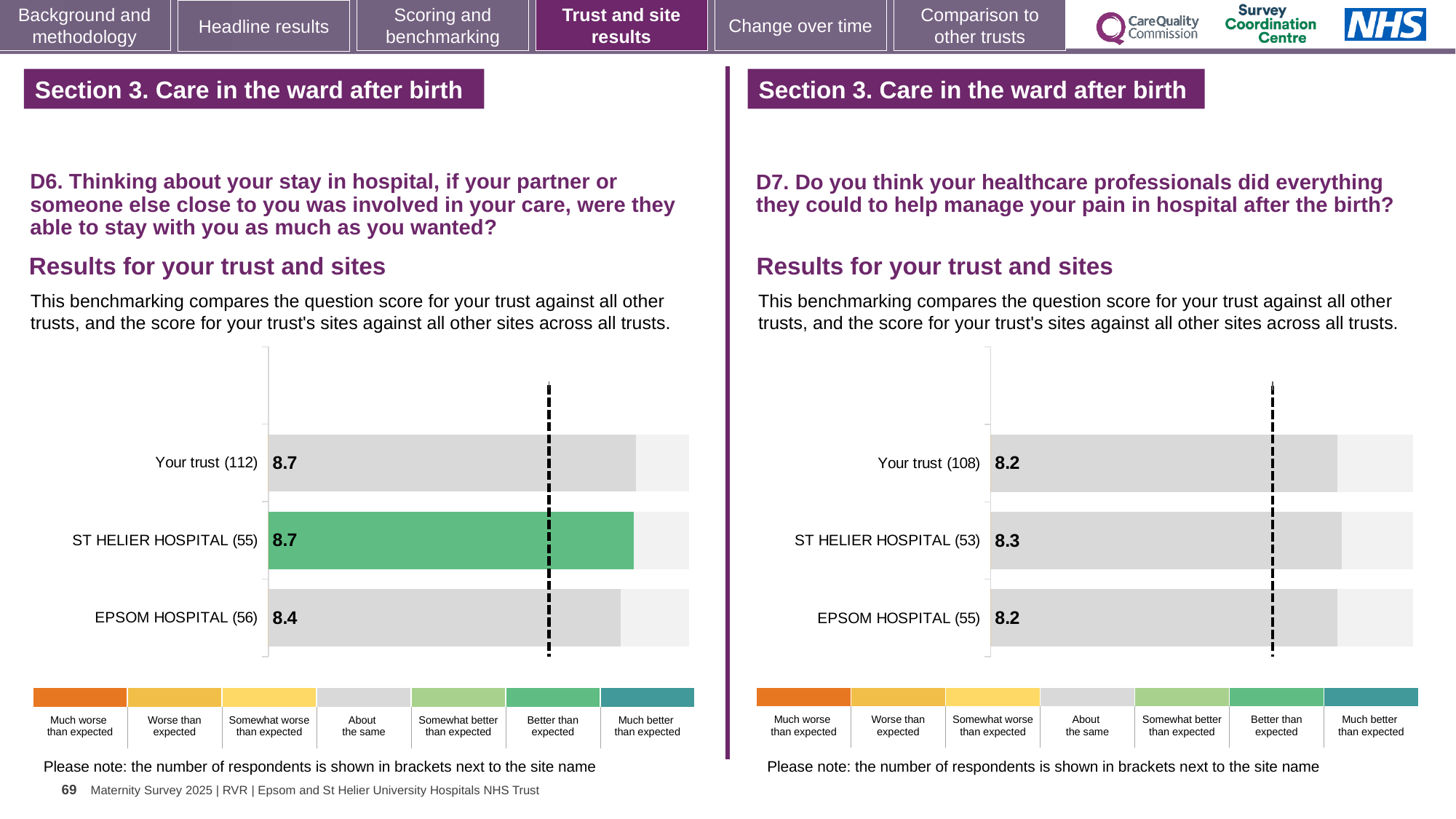
In the D6 chart on the left, which bar is coloured green? ST HELIER HOSPITAL (55) In the D6 chart on the left, what is the score for Your trust? 8.7 In the D6 chart on the left, what is the difference between the ST HELIER HOSPITAL score and the EPSOM HOSPITAL score? 0.3 In the D7 chart on the right, which site has the highest score? ST HELIER HOSPITAL In the D6 chart on the left, what is the score for EPSOM HOSPITAL? 8.4 What type of chart is used in the D6 chart on the left? Bar chart In the D7 chart on the right, how many respondents are shown for Your trust? 108 How many bars are plotted in the D7 chart on the right? 3 In the D6 chart on the left, how many respondents are shown for ST HELIER HOSPITAL? 55 In the D7 chart on the right, what is the score for ST HELIER HOSPITAL? 8.3 In the D6 chart on the left, which site has the lowest score? EPSOM HOSPITAL In the D7 chart on the right, what is the score for Your trust? 8.2